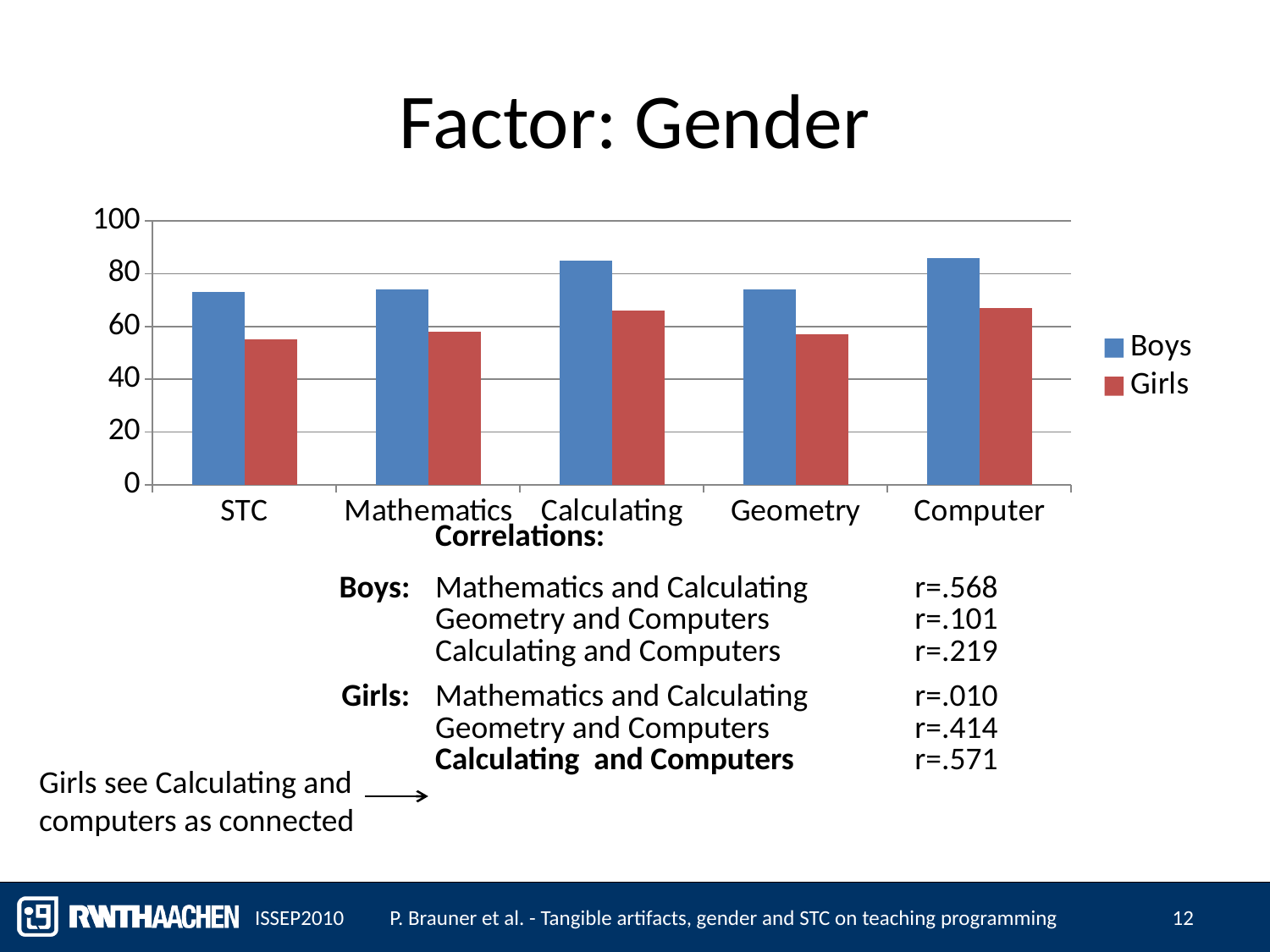
Which is larger in the Geometry category, the value for Boys or the value for Girls? Boys Which series is shown in blue in the chart? Boys Is the value for Boys in Computer greater or less than 80? greater Is the value for Boys in Calculating greater or less than 80? greater How many series does the chart legend list? 2 Is the value for Girls in Computer greater or less than 60? greater How many categories are shown on the x axis of the chart? 5 What kind of chart is shown on the slide? bar chart For Girls, which is larger, the value for Computer or the value for STC? Computer For Boys, which is larger, the value for Calculating or the value for STC? Calculating